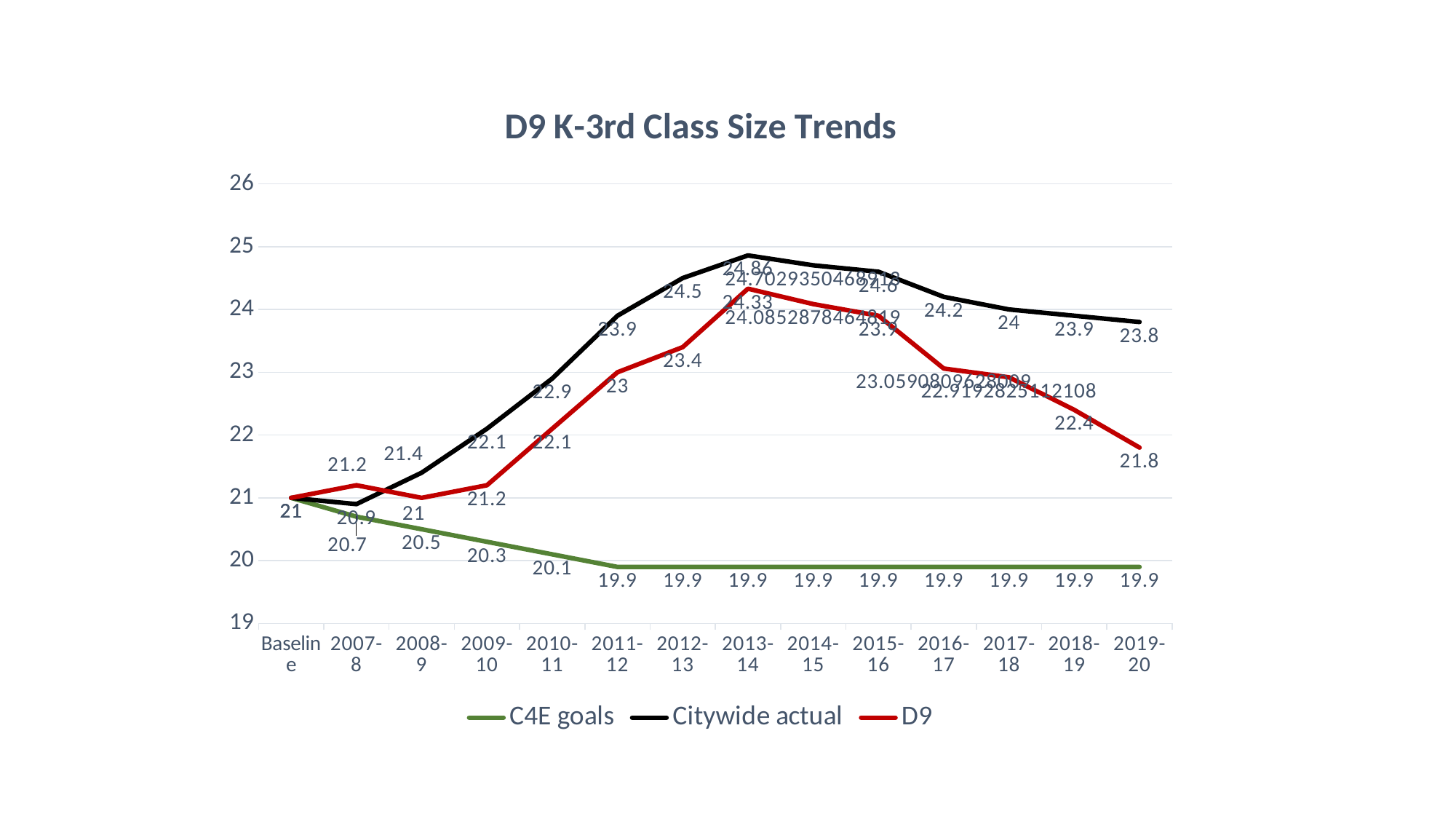
What is the D9 value for 2019-20? 21.8 Is the Citywide actual value for 2014-15 greater or less than 24? greater What colour is the D9 line in the legend? red In which year is the Citywide actual value highest? 2013-14 What is the difference between the Citywide actual and D9 values in 2019-20? 2 What is the C4E goals value for 2010-11? 20.1 What kind of chart is shown on the slide? line chart How many series does the legend list? 3 Do the C4E goals values rise or fall from Baseline to 2011-12? fall How many categories are shown along the x axis? 14 What is the Citywide actual value for 2013-14? 24.86 In 2012-13, which is larger: the Citywide actual value or the D9 value? Citywide actual